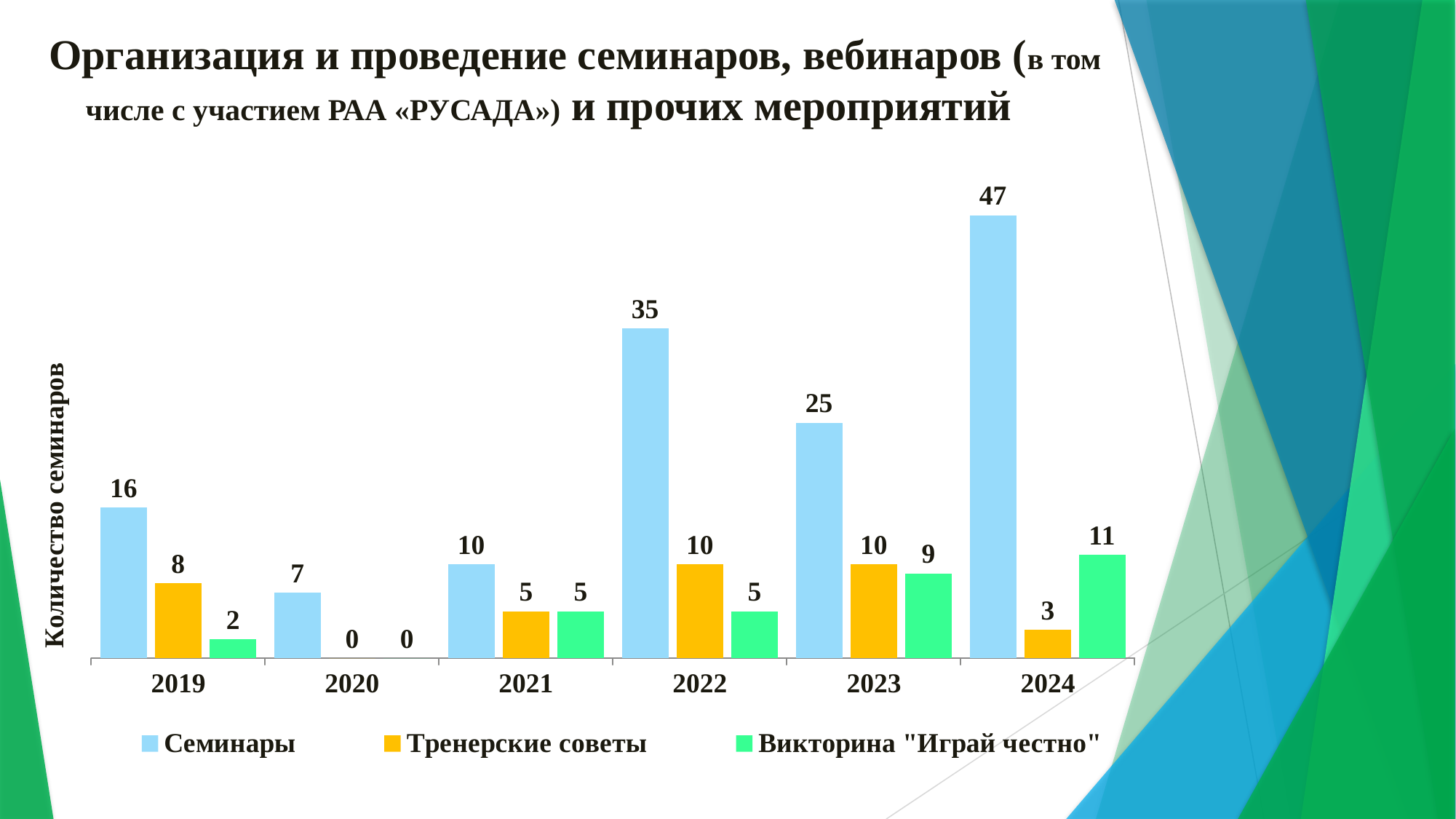
How many years are shown on the x axis? 6 What is the value for Тренерские советы in 2019? 8 What is the value for Семинары in 2024? 47 Which is larger: Тренерские советы in 2022 or Тренерские советы in 2024? Тренерские советы in 2022 How many series does the legend list? 3 What kind of chart is shown on the slide? bar chart In which year is the value for Семинары the lowest? 2020 What is the value for Викторина "Играй честно" in 2023? 9 In which year is the value for Семинары the highest? 2024 What is the label of the vertical axis? Количество семинаров Does the value for Викторина "Играй честно" rise or fall from 2022 to 2024? rise What is the difference between the Семинары values for 2024 and 2023? 22